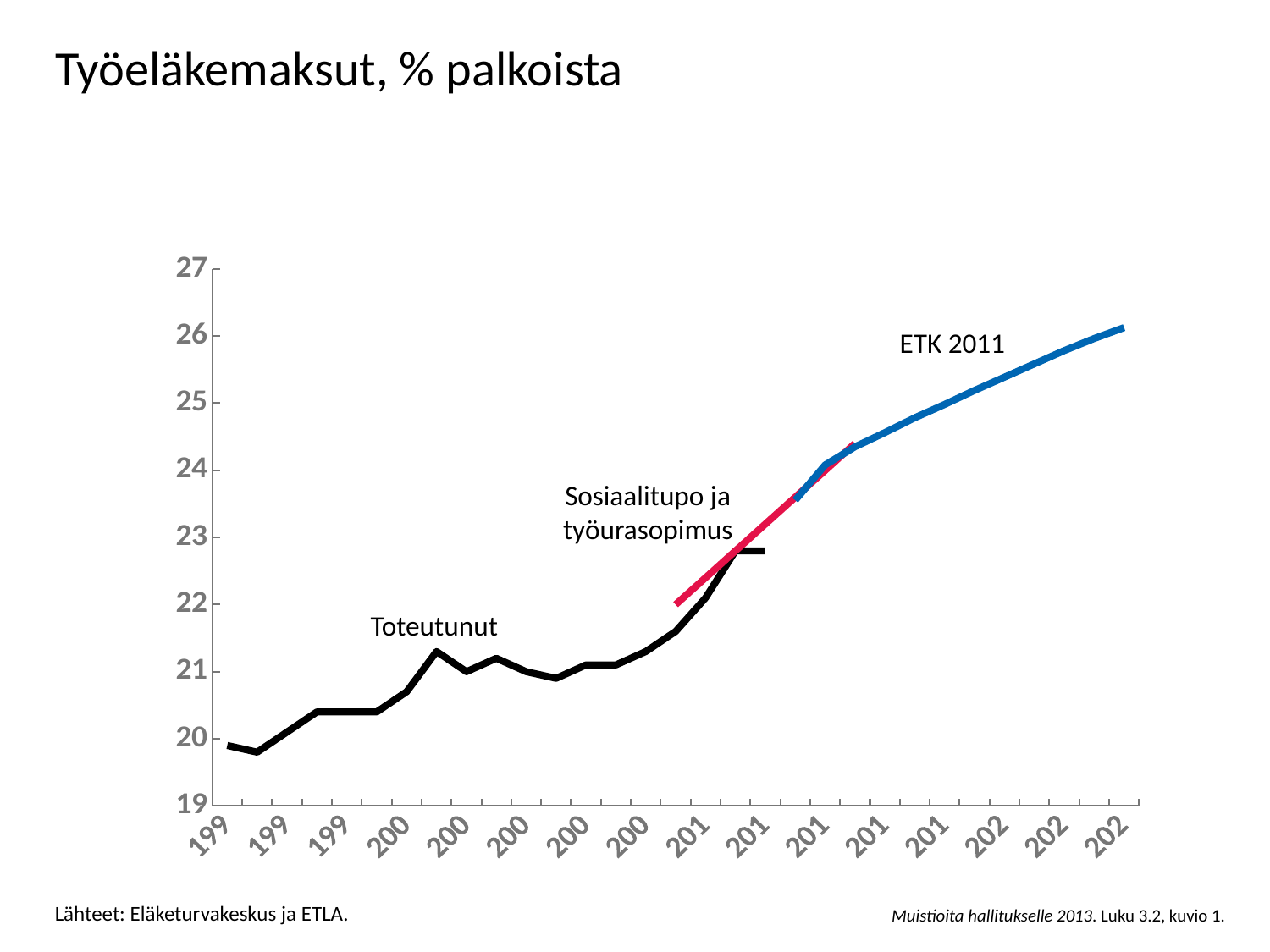
Is the value at the right end of the ETK 2011 line greater or less than 25? greater Which is larger: the value at the right end of the ETK 2011 line or the value at the right end of the Toteutunut line? ETK 2011 Is the value at the right end of the Sosiaalitupo ja työurasopimus line greater or less than 23? greater Which line contains the lowest value on the chart? Toteutunut What is the title of the chart? Työeläkemaksut, % palkoista How many labelled lines (series) are plotted on the chart? 3 What colour is the ETK 2011 line? blue Does the ETK 2011 line rise or fall along the x axis? rise Is the value at the left end of the Sosiaalitupo ja työurasopimus line greater or less than 23? less Which line reaches the highest value on the chart? ETK 2011 What kind of chart is shown on the slide? line chart